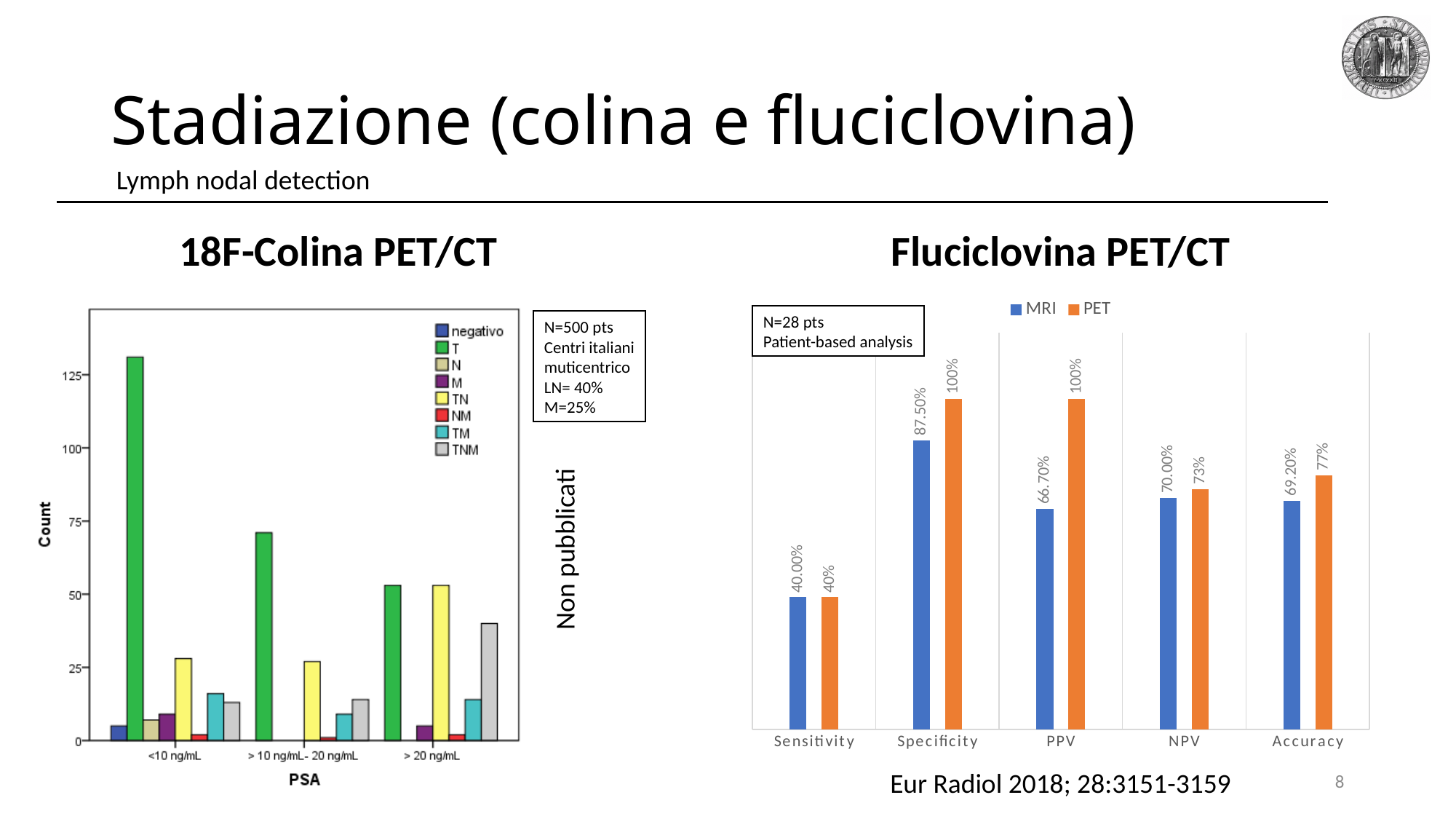
In the 18F-Colina PET/CT chart, is the count for TNM at > 20 ng/mL greater or less than 50? less In the Fluciclovina PET/CT chart, which category has the lowest MRI value? Sensitivity In the Fluciclovina PET/CT chart, what is the difference between the PET and MRI values for PPV? 33.30% In the 18F-Colina PET/CT chart, is the count for T at <10 ng/mL greater or less than 125? greater In the Fluciclovina PET/CT chart, which is larger for NPV, the MRI value or the PET value? PET How many categories are shown on the x axis of the Fluciclovina PET/CT chart? 5 What kind of chart is the 18F-Colina PET/CT chart? Bar chart In the Fluciclovina PET/CT chart, what is the MRI value for Specificity? 87.50% How many series does the legend of the 18F-Colina PET/CT chart list? 8 In the Fluciclovina PET/CT chart, what is the PET value for Accuracy? 77% In the Fluciclovina PET/CT chart, what is the MRI value for PPV? 66.70% How many series does the legend of the Fluciclovina PET/CT chart list? 2